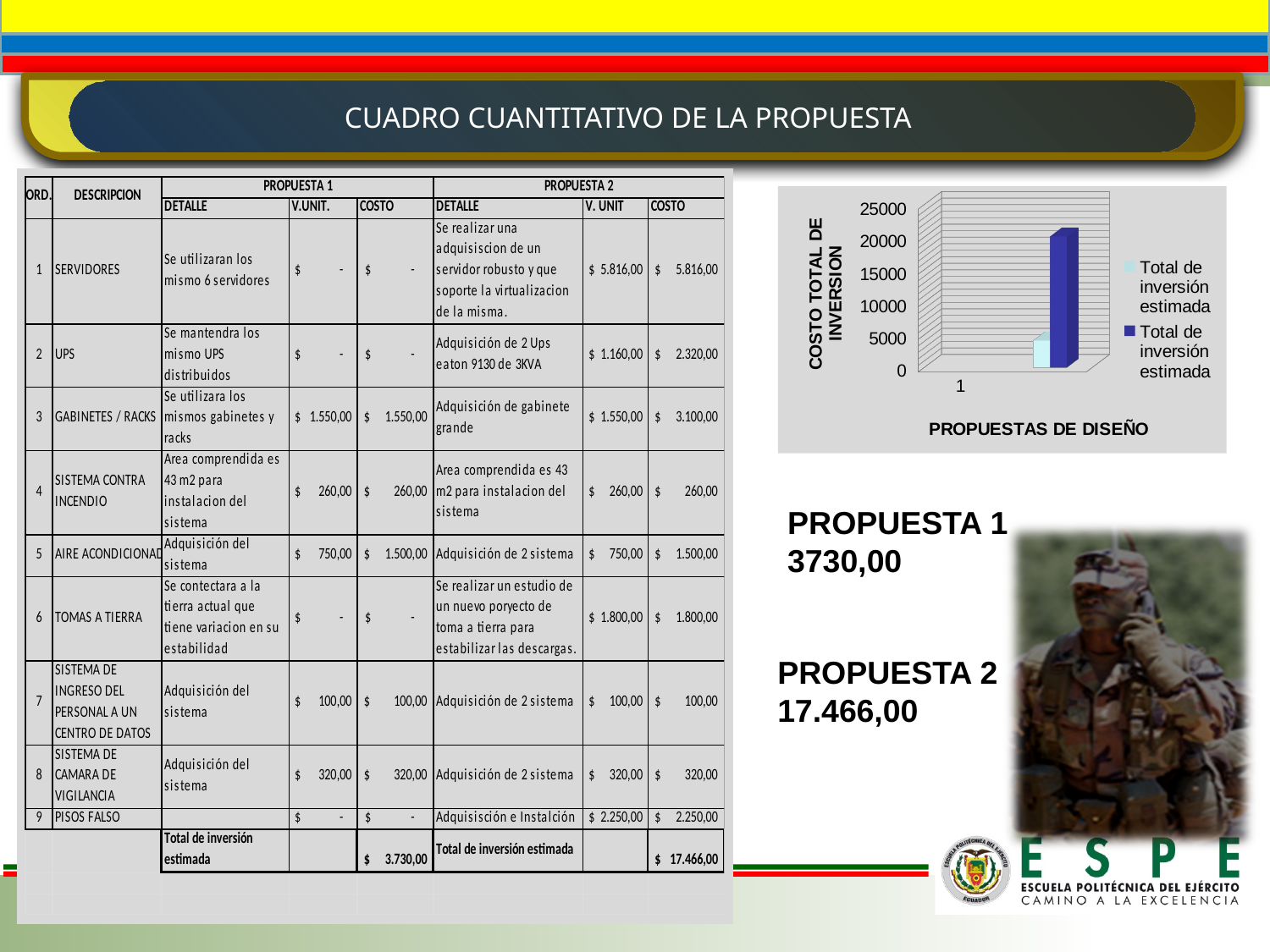
Which bar in the chart has the lowest value? the light blue bar Is the value of the dark blue bar in the chart greater or less than 15000? greater How many categories are shown on the x axis of the chart? 1 Which bar in the chart is taller, the light blue one or the dark blue one? the dark blue one What is the highest value shown on the vertical axis of the chart? 25000 What is the title shown below the horizontal axis of the chart? PROPUESTAS DE DISEÑO What kind of chart is shown on the slide? bar chart How many series does the chart's legend list? 2 What is the title of the vertical axis of the chart? COSTO TOTAL DE INVERSION What is the category label shown on the x axis of the chart? 1 Is the value of the light blue bar in the chart greater or less than 5000? less